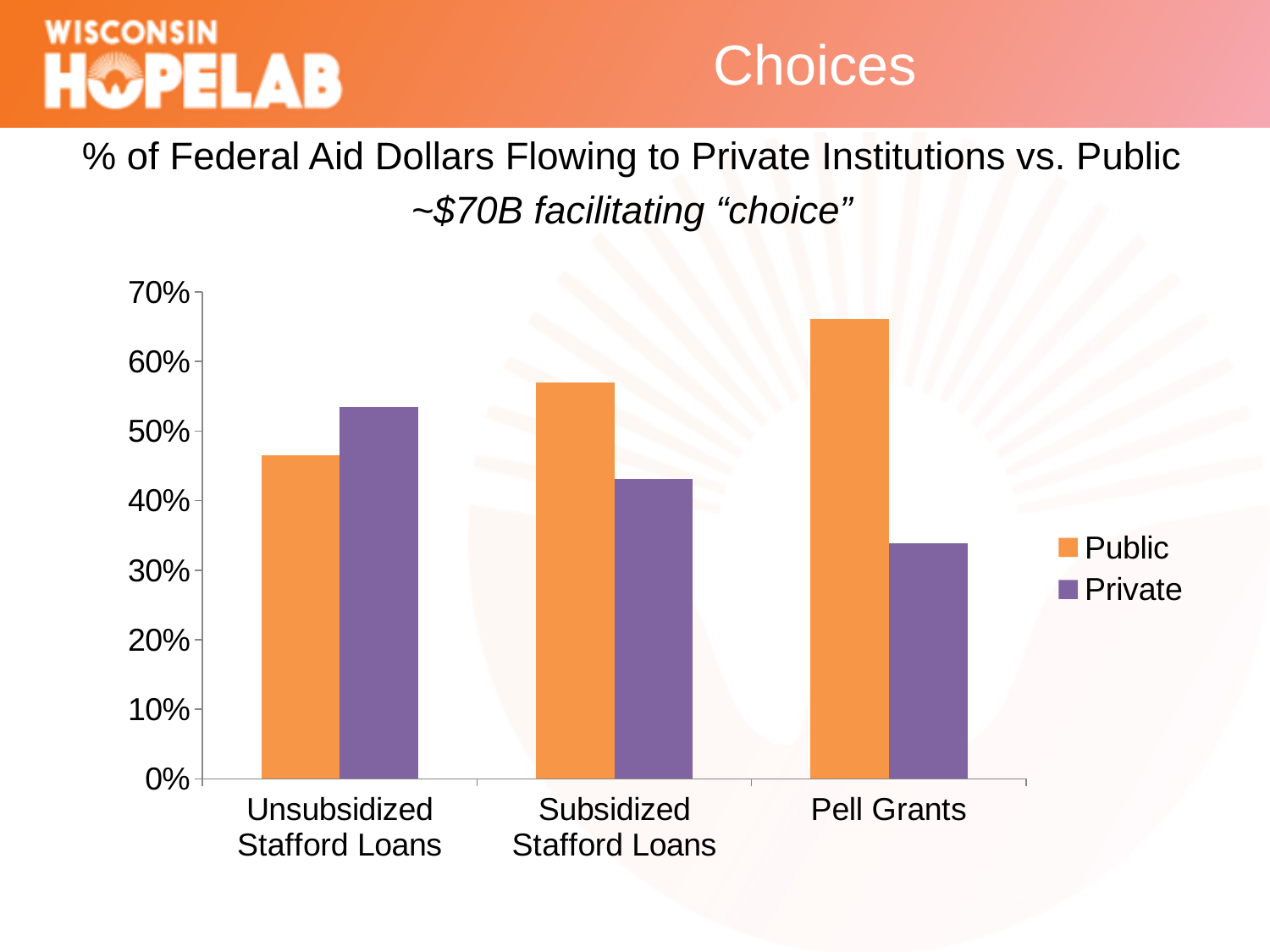
Which category has the lowest Private value? Pell Grants How many categories are shown on the x axis? 3 Is the Public value for Unsubsidized Stafford Loans greater or less than 50%? less Which category has the highest Public value? Pell Grants Is the Private value for Pell Grants greater or less than 40%? less How many series does the legend list? 2 What colour are the Public bars? orange Which series has the higher value for Unsubsidized Stafford Loans, Public or Private? Private Is the Public value for Pell Grants greater or less than 60%? greater Which series has the higher value for Pell Grants, Public or Private? Public Do the Private values rise or fall moving from Unsubsidized Stafford Loans to Pell Grants along the x axis? fall What kind of chart is shown on the slide? bar chart